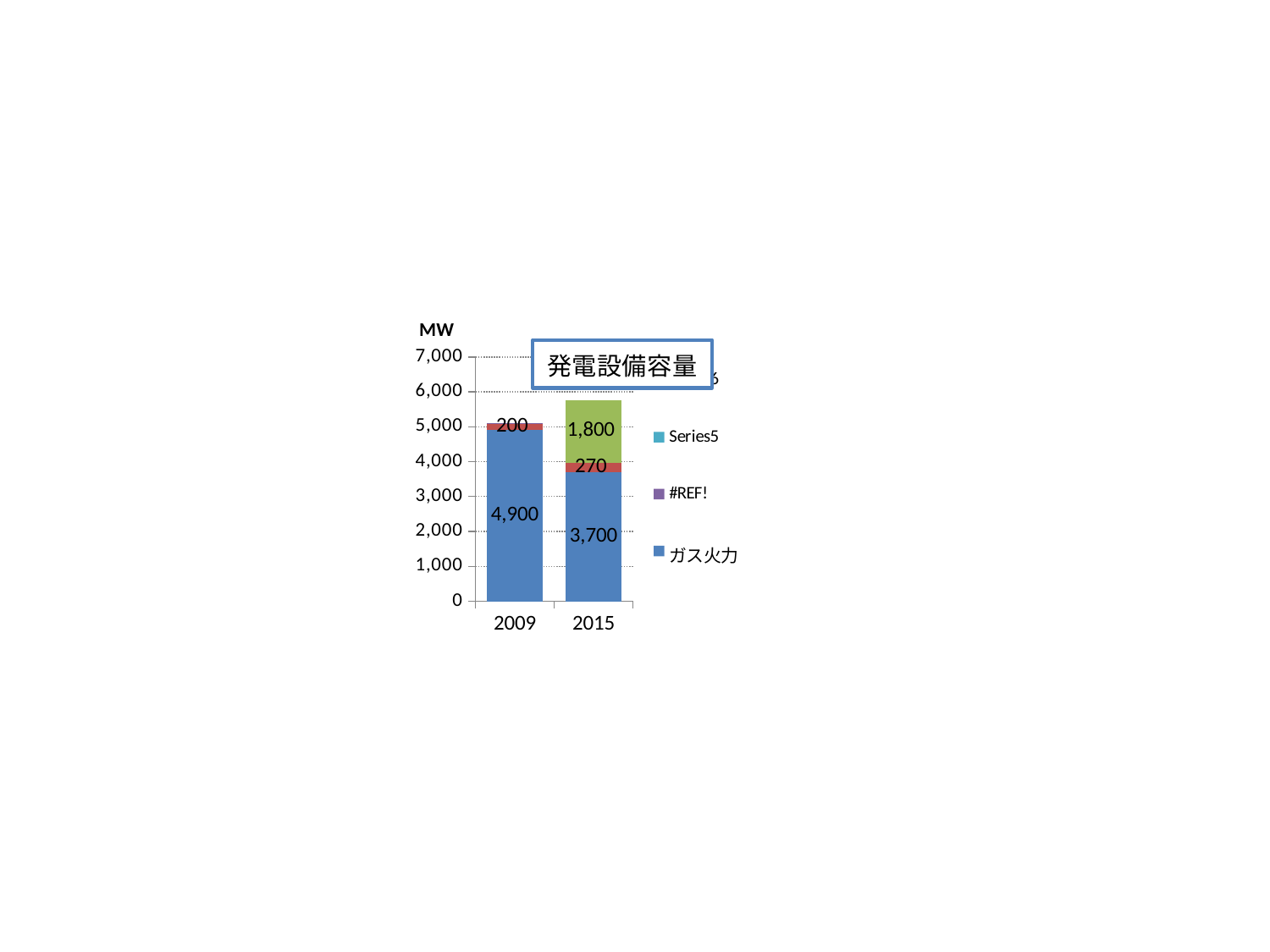
What is the total of the stacked bar for 2015? 5,770 What is the value of the red segment in the 2015 bar? 270 By how much does ガス火力 in 2009 exceed ガス火力 in 2015? 1,200 How many years (categories) are shown on the x axis? 2 What is the total of the stacked bar for 2009? 5,100 What is the title of the chart? 発電設備容量 What is the value of ガス火力 in 2009? 4,900 What is the value of the green segment in the 2015 bar? 1,800 Which year has the larger ガス火力 value, 2009 or 2015? 2009 What is the value of ガス火力 in 2015? 3,700 What unit is shown on the vertical axis of the chart? MW What kind of chart is shown on the slide? stacked bar chart